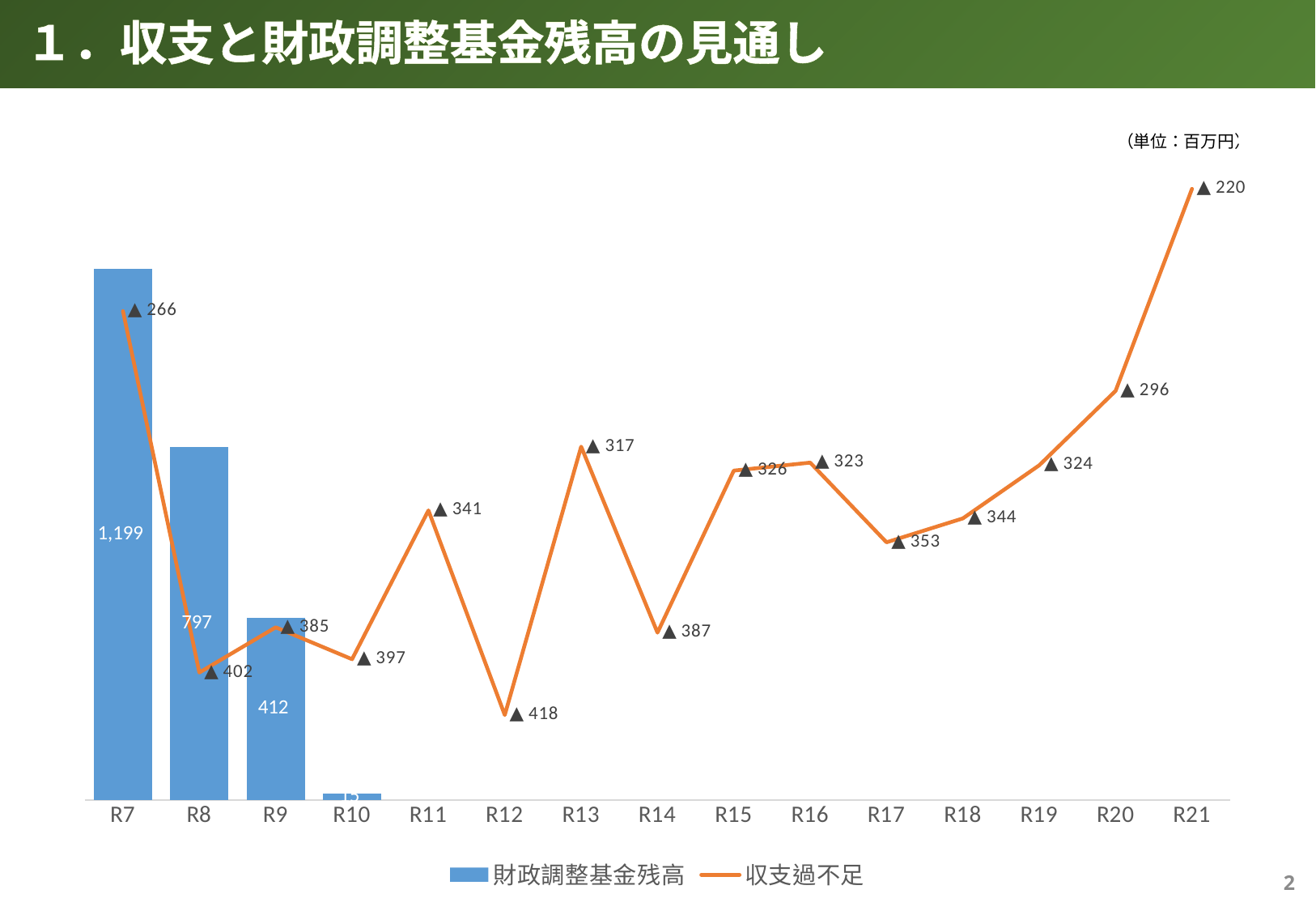
Which year has the highest point on the 収支過不足 line? R21 What is the difference between the 財政調整基金残高 values for R7 and R8? 402 Which is taller, the 財政調整基金残高 bar for R8 or for R9? R8 What is the value of 財政調整基金残高 for R9? 412 What is the value of 財政調整基金残高 for R7? 1,199 What is the 収支過不足 data label for R21? ▲ 220 Which year has the tallest 財政調整基金残高 bar? R7 Does the 収支過不足 line rise or fall from R17 to R21? rise What is the 収支過不足 data label for R12? ▲ 418 How many series does the legend list? 2 How many years are shown on the x axis? 15 Which year has the lowest point on the 収支過不足 line? R12